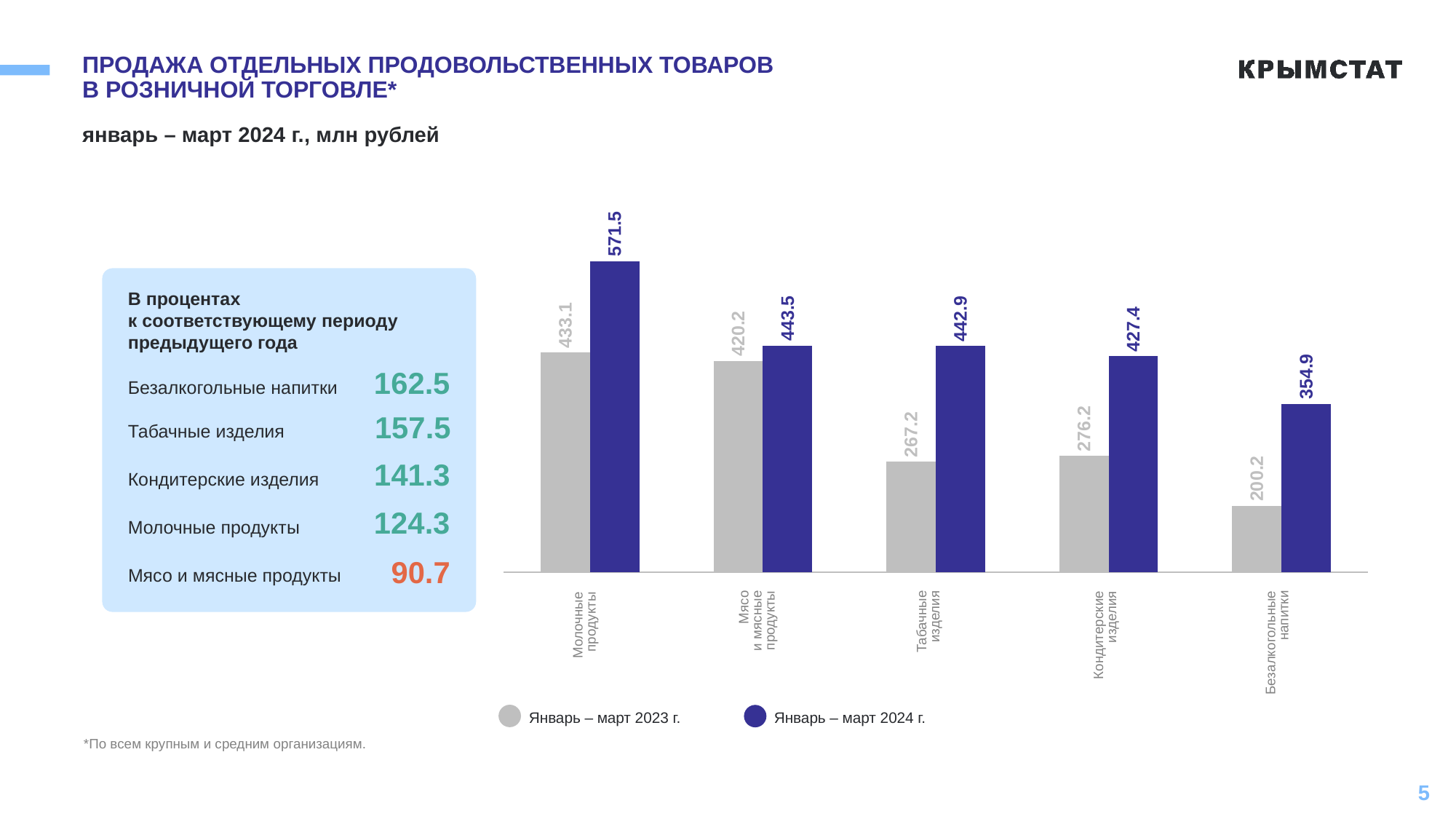
What is the difference between the 2024 and 2023 values for Кондитерские изделия? 151.2 Which category has the highest value in Январь – март 2024 г.? Молочные продукты What is the value for Табачные изделия in Январь – март 2024 г.? 442.9 What is the difference between the 2024 and 2023 values for Молочные продукты? 138.4 What is the value for Безалкогольные напитки in Январь – март 2023 г.? 200.2 How many product categories are shown on the x axis? 5 Which category has the lowest value in Январь – март 2023 г.? Безалкогольные напитки What type of chart is shown on the slide? Bar chart How many series does the legend list? 2 Which colour represents Январь – март 2023 г. in the legend? Grey Which is larger for Мясо и мясные продукты: the Январь – март 2023 г. value or the Январь – март 2024 г. value? Январь – март 2024 г. What is the value for Молочные продукты in Январь – март 2024 г.? 571.5